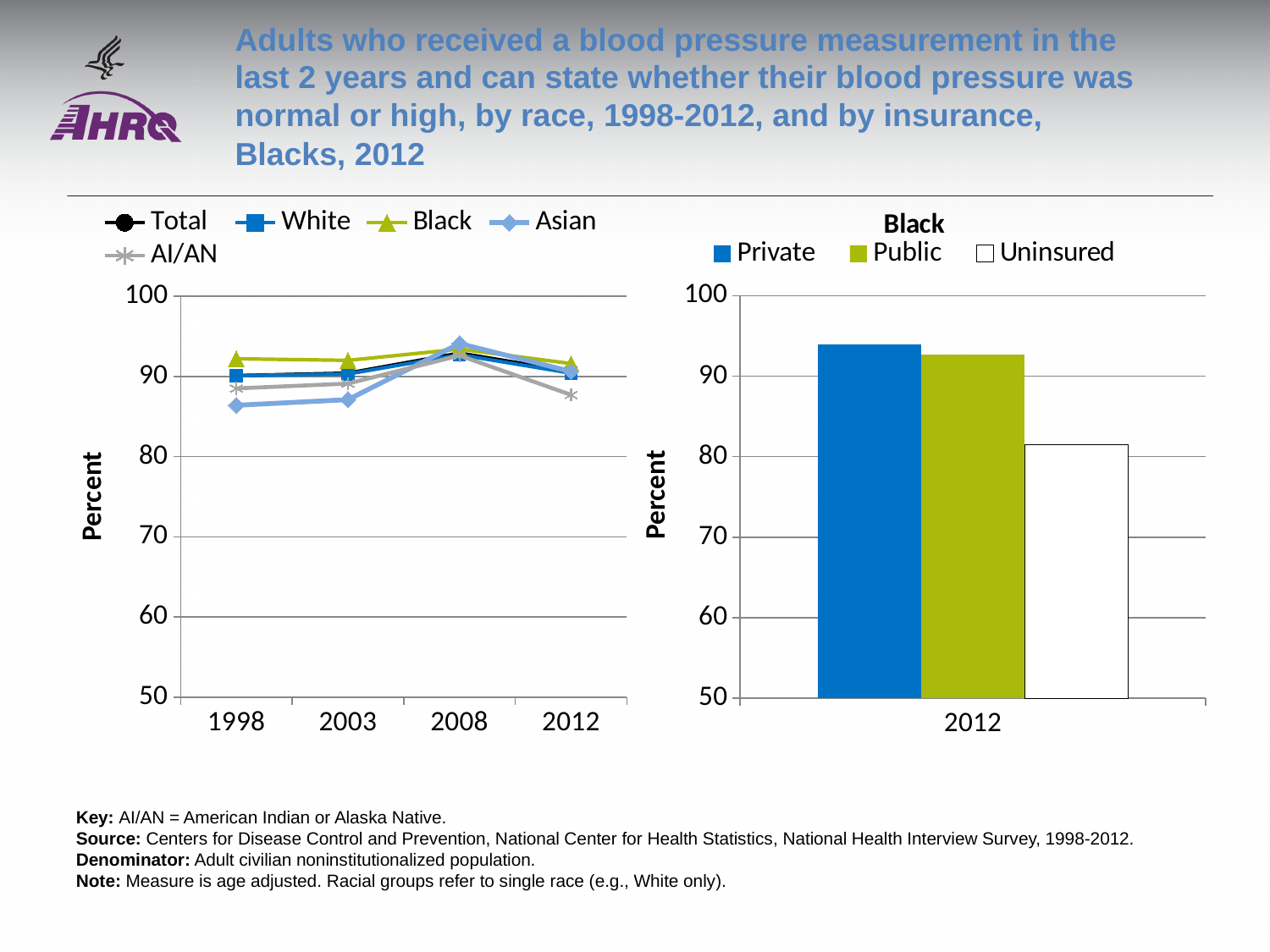
What kind of chart is the right chart titled Black? bar chart In the right chart titled Black, which insurance group has the lowest value? Uninsured How many years are shown on the x axis of the left chart (by race)? 4 In the right chart titled Black, is the value for Uninsured greater or less than 90? less In the right chart titled Black, which is larger, the value for Public or the value for Uninsured? Public What kind of chart is the left chart showing rates by race from 1998 to 2012? line chart How many series does the legend of the right chart titled Black list? 3 How many series does the legend of the left chart (by race) list? 5 In the left chart (by race), is the value for Asian in 1998 greater or less than 90? less In the left chart (by race), does the Asian line rise or fall from 1998 to 2008? rise In the right chart titled Black, is the value for Private greater or less than 90? greater In the left chart (by race), which race group has the lowest value in 1998? Asian